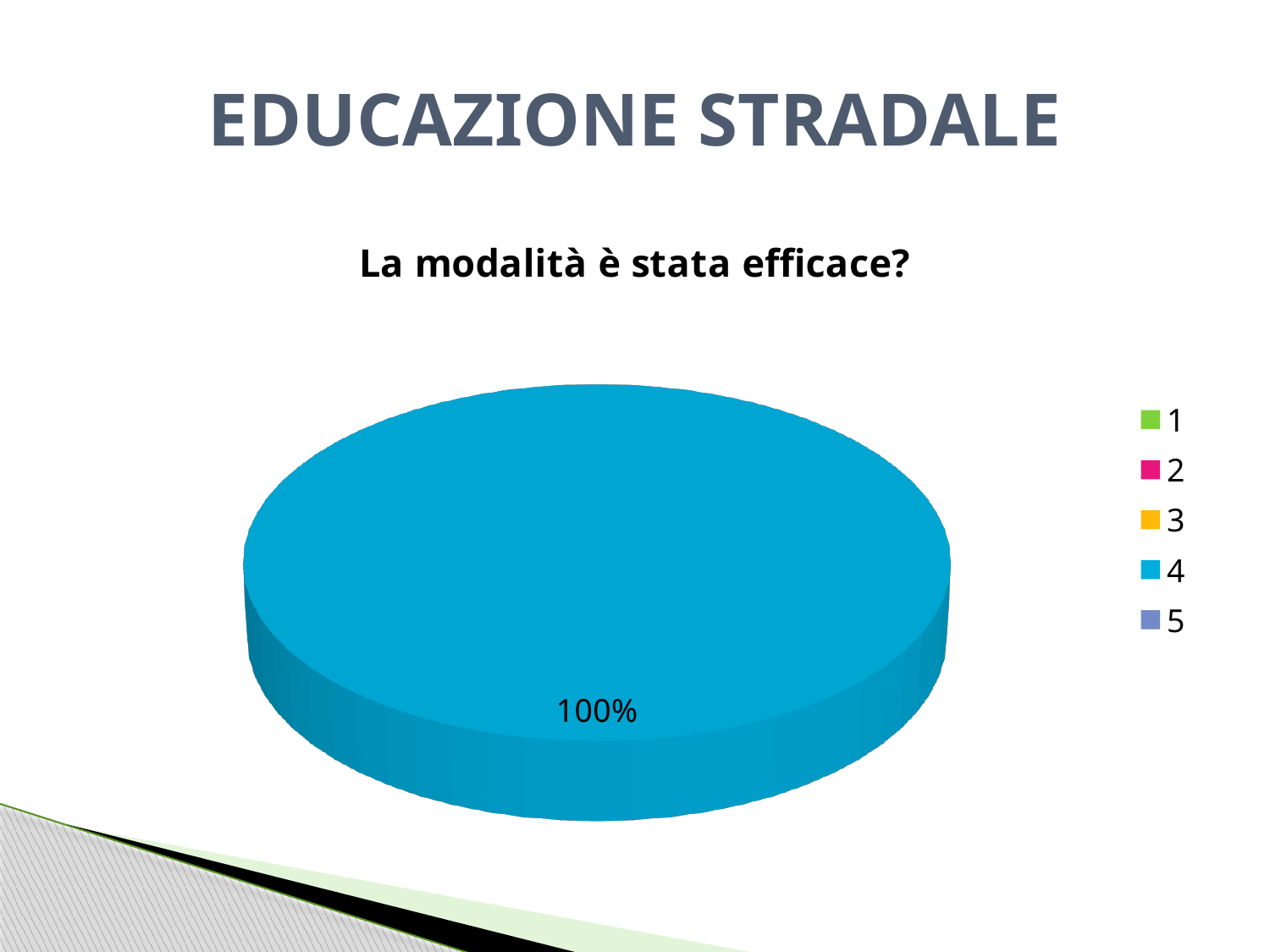
What colour is the slice for category 4? blue What is the data label printed on the pie? 100% How many entries does the legend list? 5 Which category takes the largest share of the pie? 4 What share of the pie does category 4 take? 100% How many slices are visible in the pie? 1 What kind of chart is shown on the slide? pie chart What is the title of the chart? La modalità è stata efficace?